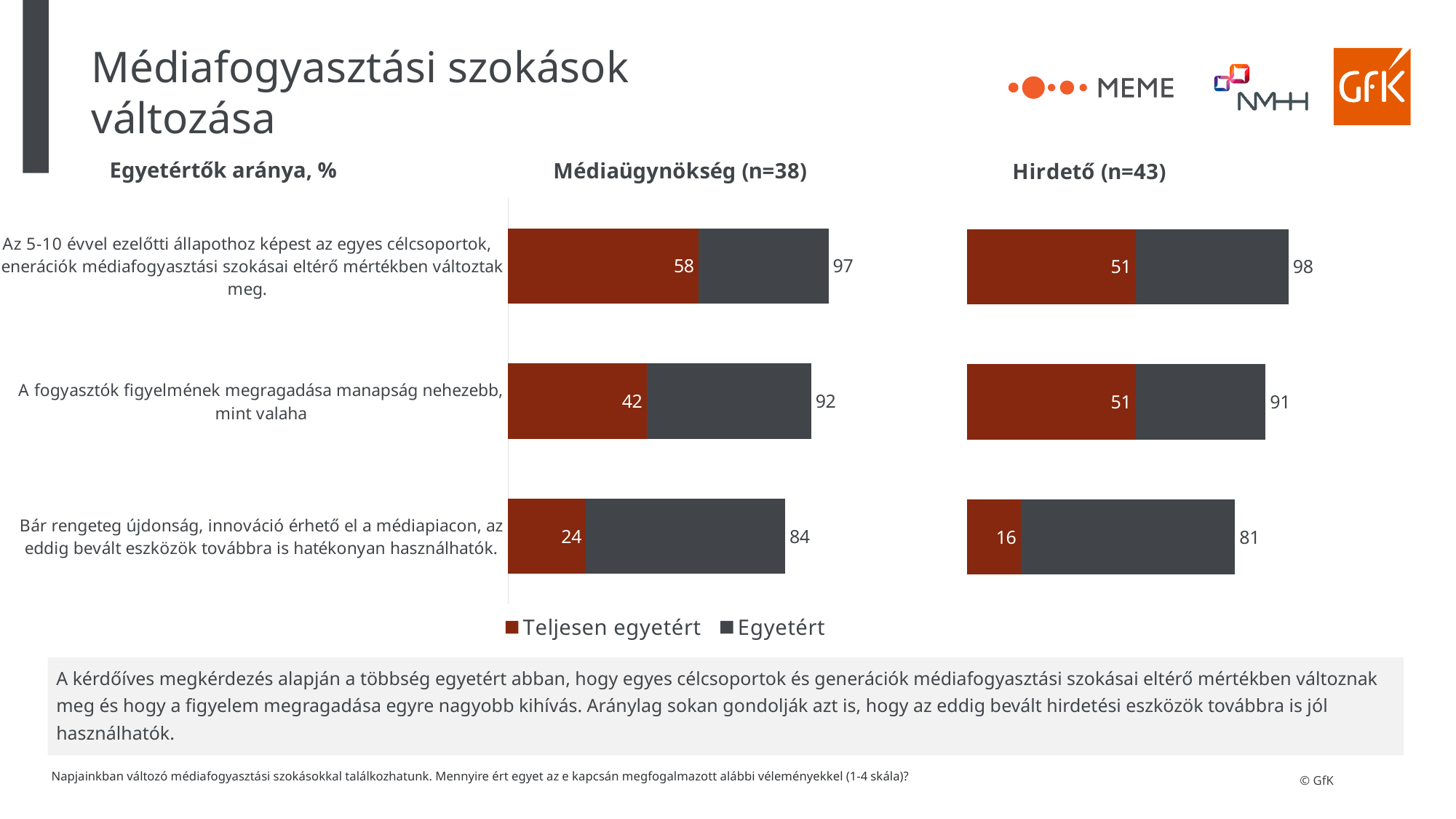
In the Hirdető (n=43) chart, what is the 'Teljesen egyetért' value for the statement about the 5-10 years ago comparison ('Az 5-10 évvel ezelőtti állapothoz képest...')? 51 In the Médiaügynökség (n=38) chart, which statement has the highest total agreement value? Az 5-10 évvel ezelőtti állapothoz képest az egyes célcsoportok, generációk médiafogyasztási szokásai eltérő mértékben változtak meg. What is the difference between the 'Teljesen egyetért' values for 'A fogyasztók figyelmének megragadása manapság nehezebb, mint valaha' in the Hirdető (n=43) chart and the Médiaügynökség (n=38) chart? 9 In the Hirdető (n=43) chart, which statement has the lowest 'Teljesen egyetért' value? Bár rengeteg újdonság, innováció érhető el a médiapiacon, az eddig bevált eszközök továbbra is hatékonyan használhatók. In the Médiaügynökség (n=38) chart, what is the 'Teljesen egyetért' value for the statement 'A fogyasztók figyelmének megragadása manapság nehezebb, mint valaha'? 42 In the Hirdető (n=43) chart, what is the total agreement value shown at the end of the bar for 'Bár rengeteg újdonság, innováció érhető el a médiapiacon, az eddig bevált eszközök továbbra is hatékonyan használhatók.'? 81 Which legend entry is shown in dark red? Teljesen egyetért What kind of chart is the Hirdető (n=43) chart? Stacked bar chart In the Médiaügynökség (n=38) chart, what is the difference between the total agreement values of the first statement (97) and the third statement (84)? 13 How many series does the legend list for the charts? 2 Which is larger: the 'Teljesen egyetért' value for the third statement ('Bár rengeteg újdonság...') in the Médiaügynökség (n=38) chart or in the Hirdető (n=43) chart? Médiaügynökség (n=38) How many statements (categories) are shown in the Médiaügynökség (n=38) chart? 3